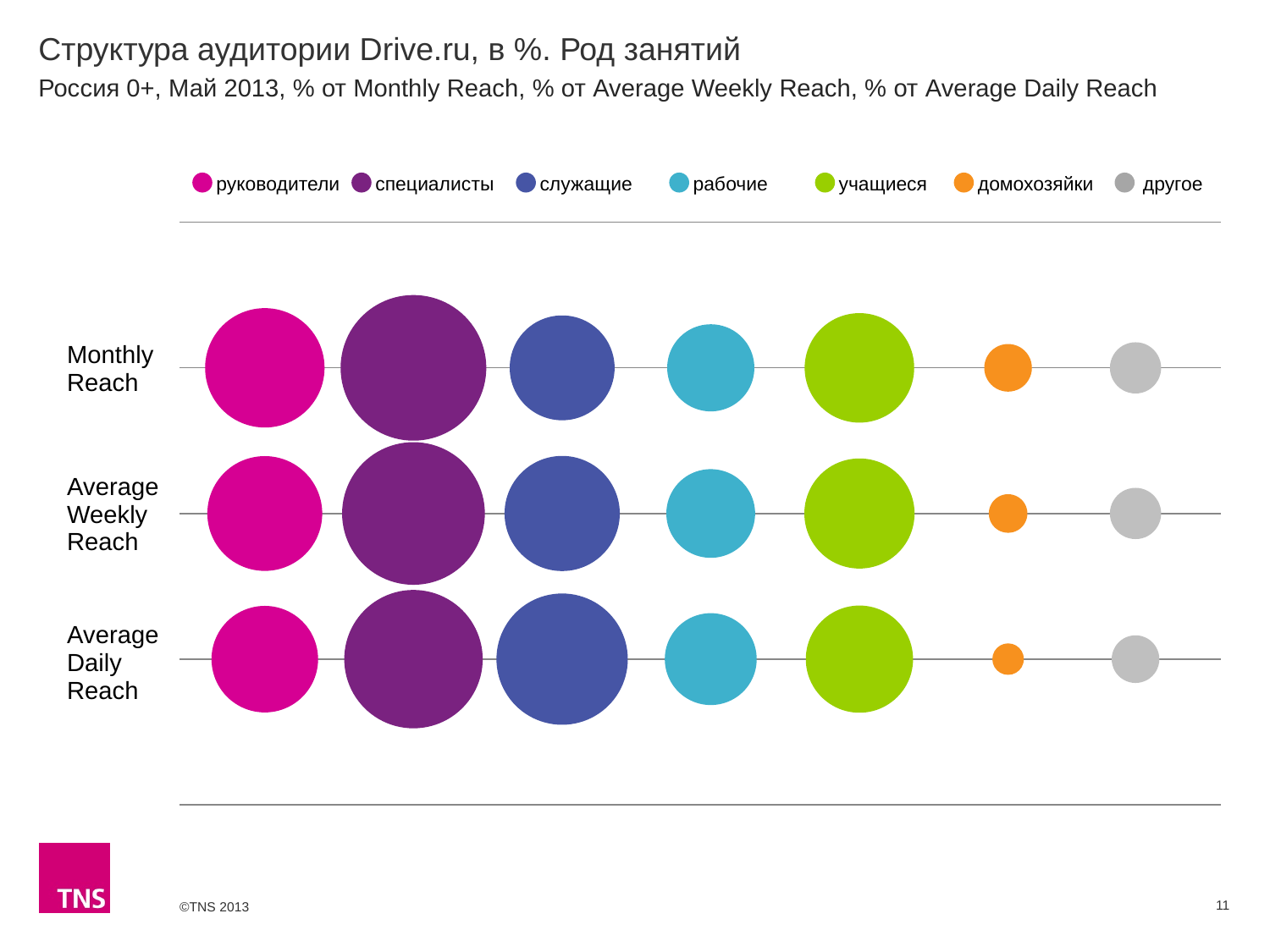
In the Average Weekly Reach row, which is larger: служащие or домохозяйки? служащие What is the title of the chart on the slide? Структура аудитории Drive.ru, в %. Род занятий In the Average Weekly Reach row, which occupation group has the smallest bubble? домохозяйки How many reach categories (rows) are plotted on the chart? 3 In the Average Daily Reach row, which occupation group has the largest bubble? специалисты How many series does the legend list? 7 What kind of chart is shown on the slide? Bubble chart In the Monthly Reach row, which occupation group has the largest bubble? специалисты In the Monthly Reach row, which occupation group has the smallest bubble? домохозяйки Which legend entry is shown in orange? домохозяйки In the Monthly Reach row, which is larger: руководители or рабочие? руководители In the Average Daily Reach row, which is larger: учащиеся or другое? учащиеся